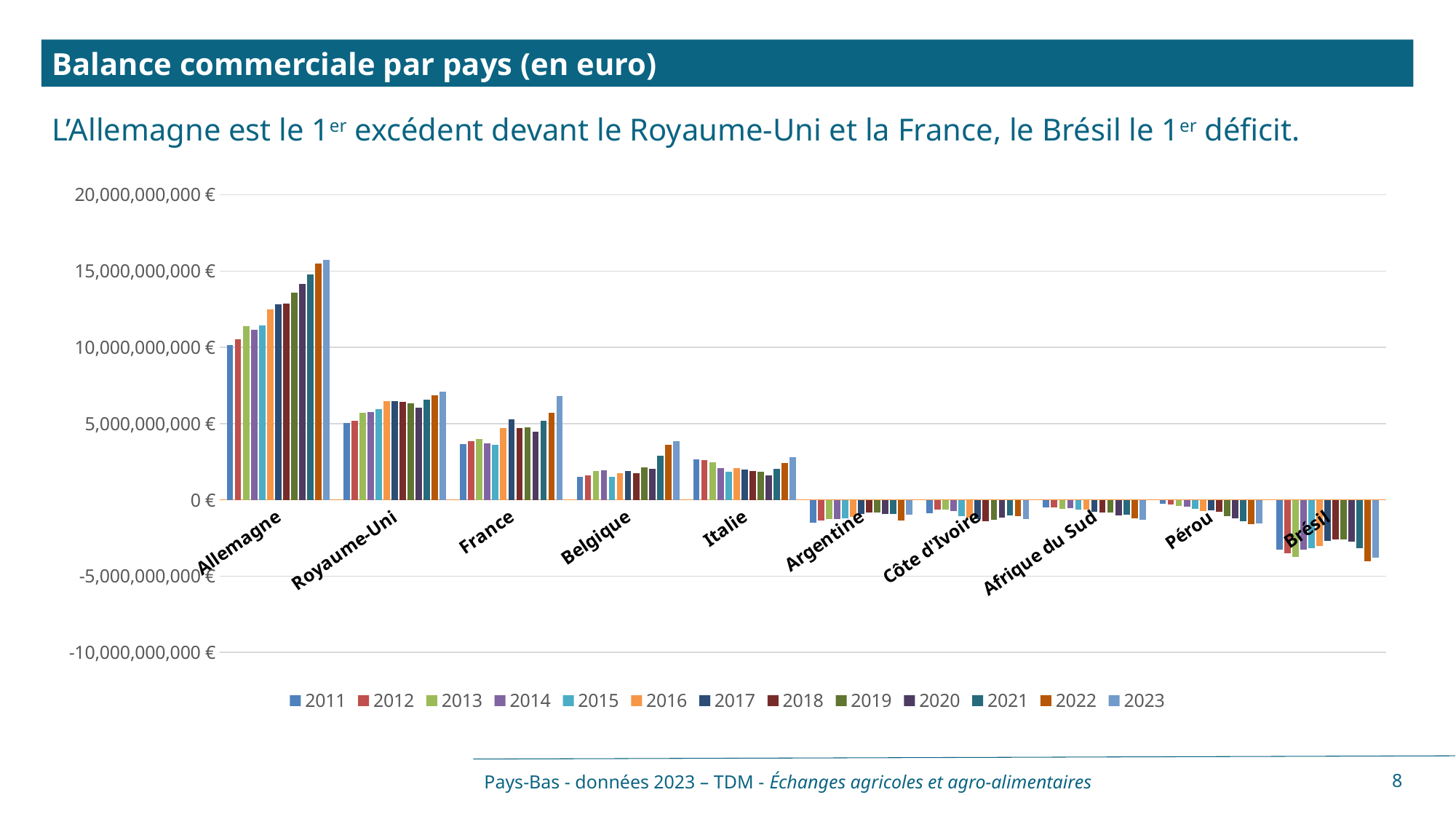
Is the 2023 value for Belgique greater or less than 5,000,000,000 €? less What kind of chart is shown on the slide? Bar chart How many series (years) does the legend list? 13 Which country has the lowest (most negative) trade balance in the chart? Brésil How many countries in the chart have negative trade balances? 5 How many countries are shown on the x axis of the chart? 10 Is the 2023 value for Allemagne greater or less than 15,000,000,000 €? greater What is the title of the chart on the slide? Balance commerciale par pays (en euro) Is the 2023 value for Royaume-Uni greater or less than 5,000,000,000 €? greater Which is larger, the 2023 value for Allemagne or the 2023 value for Royaume-Uni? Allemagne Which country has the highest trade balance in the chart? Allemagne Do the values for Allemagne generally rise or fall from 2011 to 2023? Rise